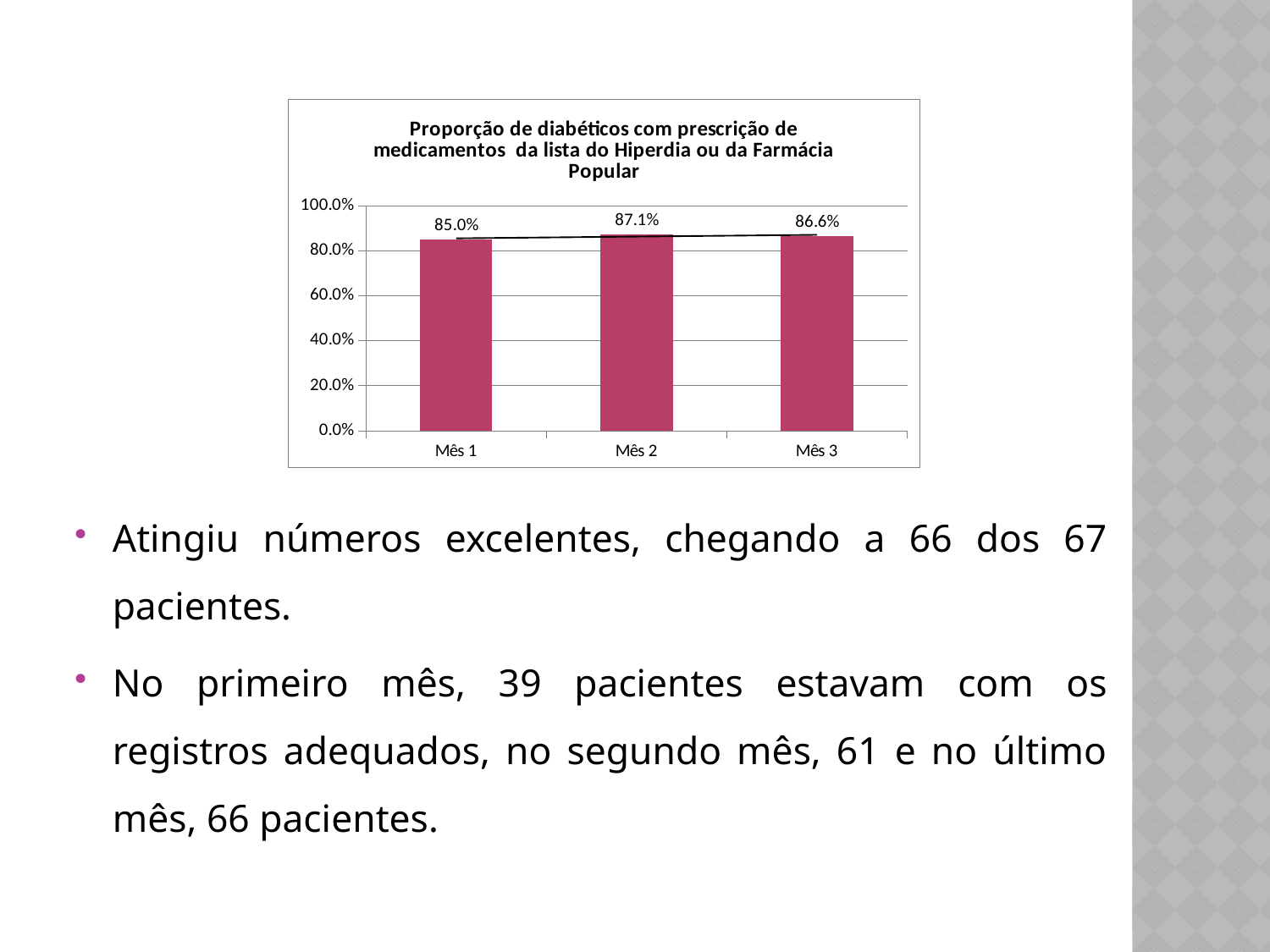
How many months are shown on the x axis? 3 Does the value rise or fall from Mês 1 to Mês 2? Rise Which month has the highest value? Mês 2 Which is larger, the value for Mês 2 or the value for Mês 3? Mês 2 Which month has the lowest value? Mês 1 What is the value for Mês 3? 86.6% What is the title of the chart? Proporção de diabéticos com prescrição de medicamentos da lista do Hiperdia ou da Farmácia Popular What is the value for Mês 1? 85.0% What is the value for Mês 2? 87.1% What is the difference between the values for Mês 2 and Mês 1? 2.1 percentage points Is the value for Mês 3 greater or less than 80.0%? greater What kind of chart is shown on the slide? Bar chart